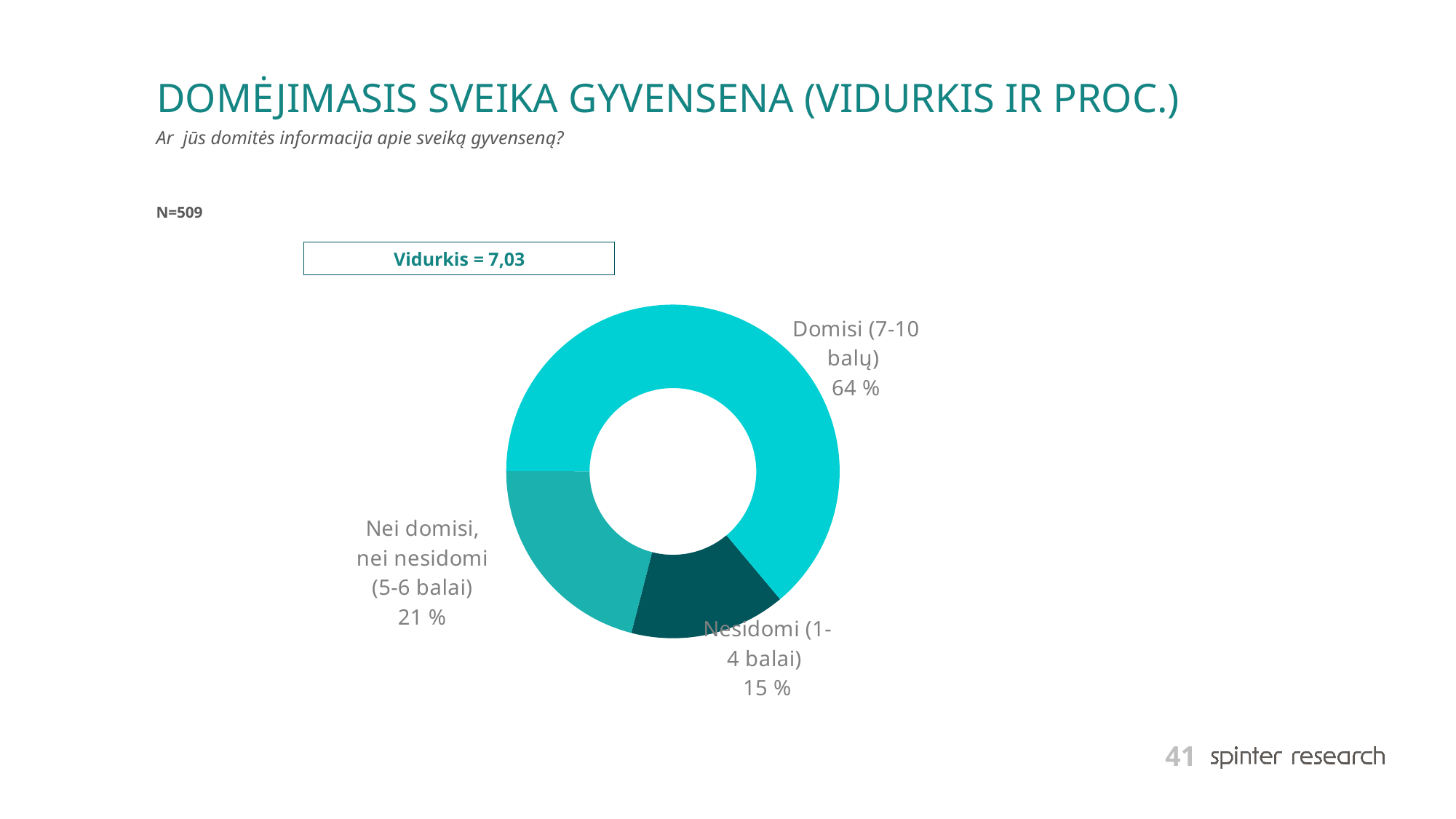
What is the difference in percentage points between 'Nei domisi, nei nesidomi (5-6 balai)' and 'Nesidomi (1-4 balai)'? 6 What is the average (Vidurkis) value shown on the slide? 7,03 What percentage of respondents are in the 'Domisi (7-10 balų)' category? 64 % What is the sample size (N) shown on the slide? 509 What percentage of respondents are in the 'Nesidomi (1-4 balai)' category? 15 % What percentage of respondents are in the 'Nei domisi, nei nesidomi (5-6 balai)' category? 21 % What kind of chart is shown on the slide? Pie chart (doughnut) Which category has the largest share of the chart? Domisi (7-10 balų) Which category has the smallest share of the chart? Nesidomi (1-4 balai) What is the difference in percentage points between 'Domisi (7-10 balų)' and 'Nesidomi (1-4 balai)'? 49 How many categories are shown in the chart? 3 Which is larger: the share for 'Nei domisi, nei nesidomi (5-6 balai)' or for 'Nesidomi (1-4 balai)'? Nei domisi, nei nesidomi (5-6 balai)